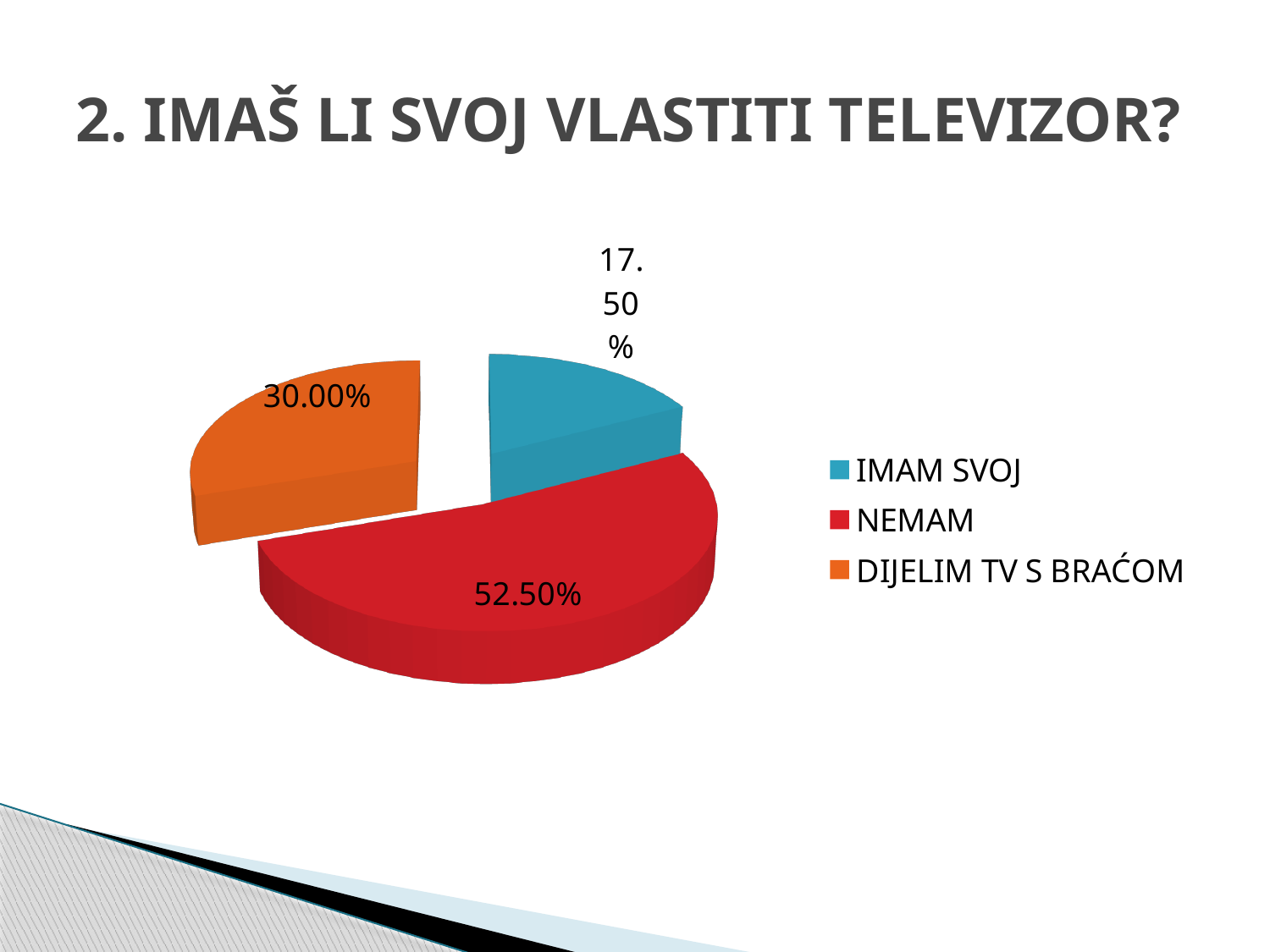
What is the value for NEMAM? 52.50% What is the difference between the values for DIJELIM TV S BRAĆOM and IMAM SVOJ? 12.50% What is the title of the slide? 2. IMAŠ LI SVOJ VLASTITI TELEVIZOR? Which category has the smallest share of the pie? IMAM SVOJ What kind of chart is shown on the slide? pie chart What is the value for DIJELIM TV S BRAĆOM? 30.00% Which is larger, the value for IMAM SVOJ or the value for DIJELIM TV S BRAĆOM? DIJELIM TV S BRAĆOM What is the difference between the values for NEMAM and DIJELIM TV S BRAĆOM? 22.50% What colour is the slice for NEMAM? red How many slices does the pie chart have? 3 Which category has the largest share of the pie? NEMAM What is the value for IMAM SVOJ? 17.50%